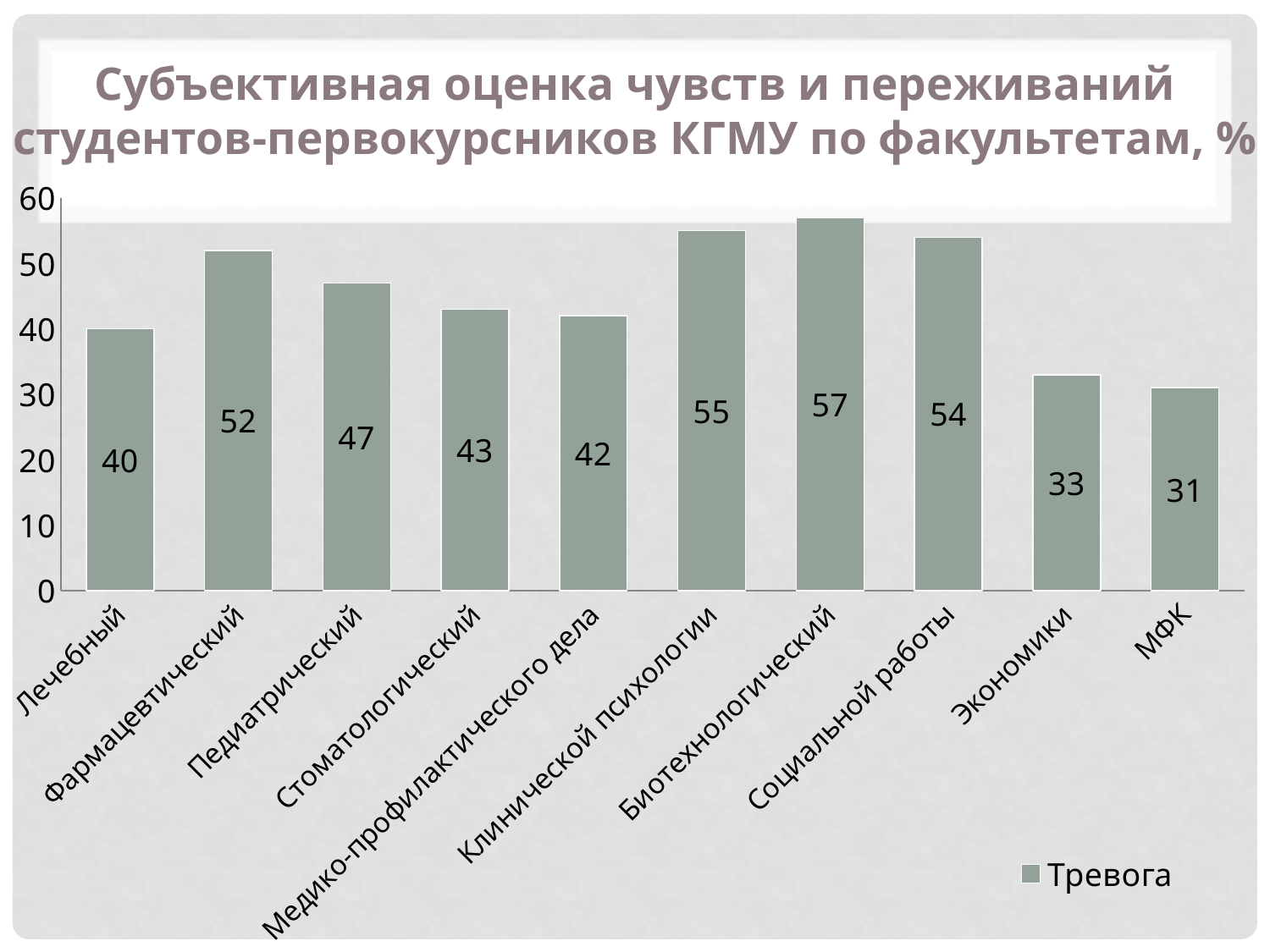
What kind of chart is shown? bar chart What is the value for Лечебный? 40 What is the difference between the values for Фармацевтический and Педиатрический? 5 How many faculties are shown on the chart? 10 Which is larger, the value for Клинической психологии or the value for Социальной работы? Клинической психологии What is the name of the series in the legend? Тревога What is the value for Биотехнологический? 57 What is the value for Экономики? 33 Which faculty has the lowest value? МФК Which faculty has the highest value? Биотехнологический Is the value for Стоматологический greater or less than 50? less How many series does the legend list? 1